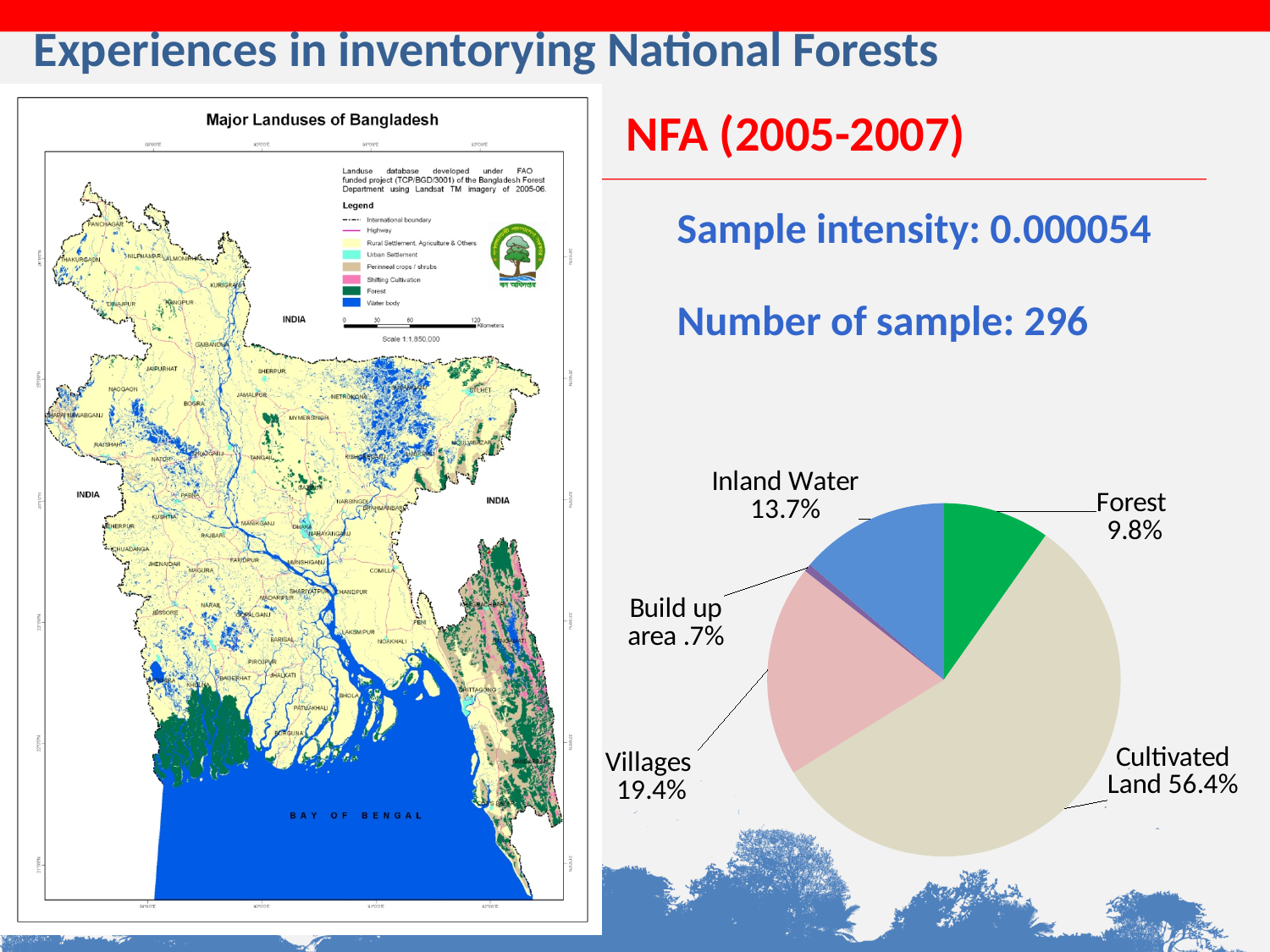
Which category has the largest slice in the pie chart? Cultivated Land In the pie chart, what share does Build up area have? .7% In the pie chart, what share does Inland Water have? 13.7% In the pie chart, what share does Forest have? 9.8% What kind of chart is shown on the right side of the slide? pie chart In the pie chart, what share does Cultivated Land have? 56.4% In the pie chart, which is larger, Villages or Inland Water? Villages How many categories are shown in the pie chart? 5 In the pie chart, what share does Villages have? 19.4% In the pie chart, what is the difference between the Cultivated Land share and the Villages share? 37.0 percentage points Which category has the smallest slice in the pie chart? Build up area In the pie chart, what is the difference between the Inland Water share and the Forest share? 3.9 percentage points